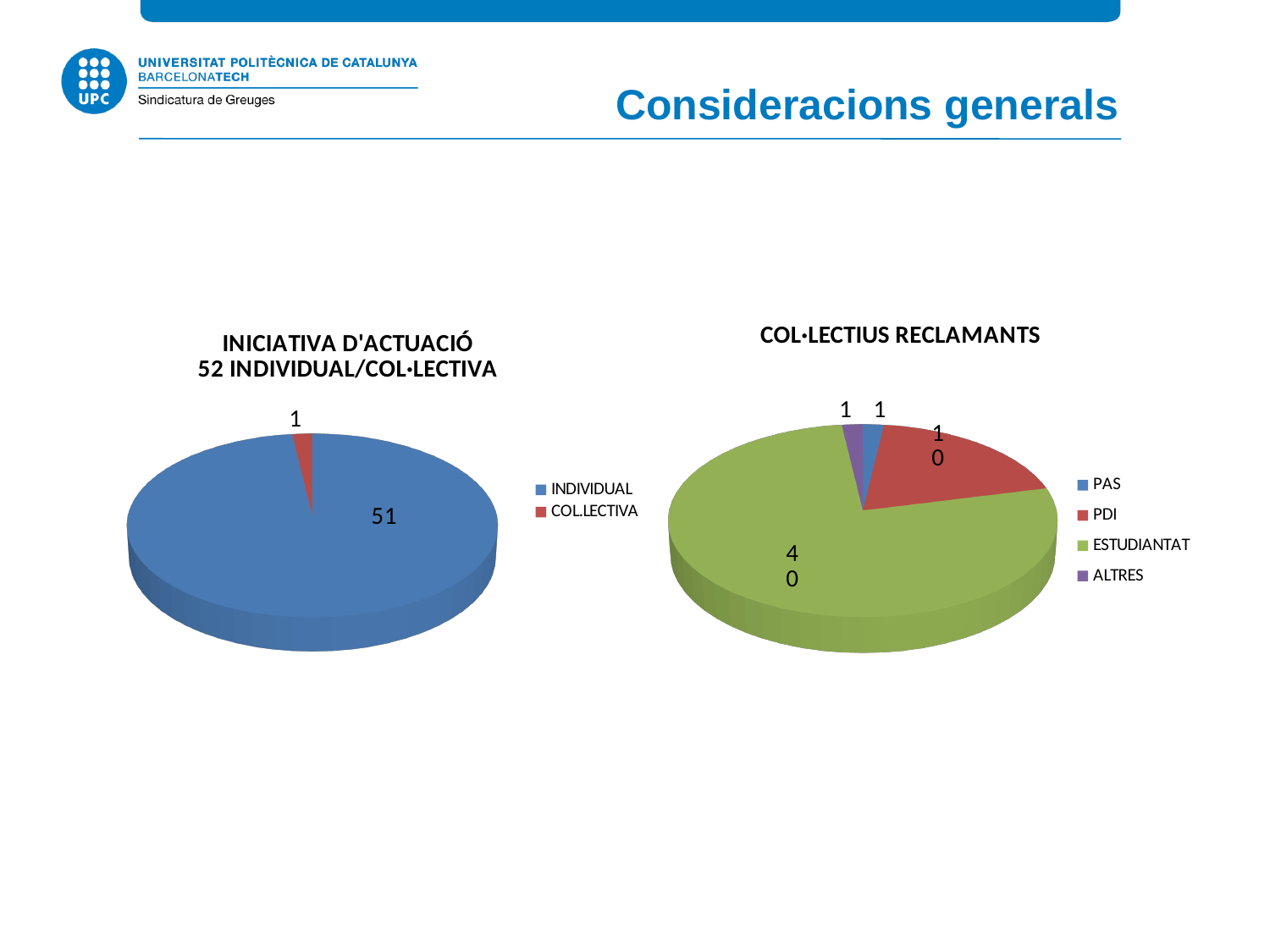
In the chart titled "COL·LECTIUS RECLAMANTS", what is the value for ESTUDIANTAT? 40 In the left chart, what is the difference between the INDIVIDUAL and COL.LECTIVA values? 50 In the right chart, what colour is the ESTUDIANTAT slice? Green In the right chart, which category has the largest slice? ESTUDIANTAT In the right chart, is the value for ESTUDIANTAT larger or smaller than the value for PDI? Larger In the left chart, which category has the largest slice? INDIVIDUAL In the chart titled "COL·LECTIUS RECLAMANTS", what is the value for PAS? 1 How many categories does the legend of the chart titled "COL·LECTIUS RECLAMANTS" list? 4 In the chart titled "COL·LECTIUS RECLAMANTS", what is the value for PDI? 10 In the chart titled "INICIATIVA D'ACTUACIÓ 52 INDIVIDUAL/COL·LECTIVA", what is the value for COL.LECTIVA? 1 What kind of chart is the chart titled "COL·LECTIUS RECLAMANTS"? Pie chart In the chart titled "INICIATIVA D'ACTUACIÓ 52 INDIVIDUAL/COL·LECTIVA", what is the value for INDIVIDUAL? 51